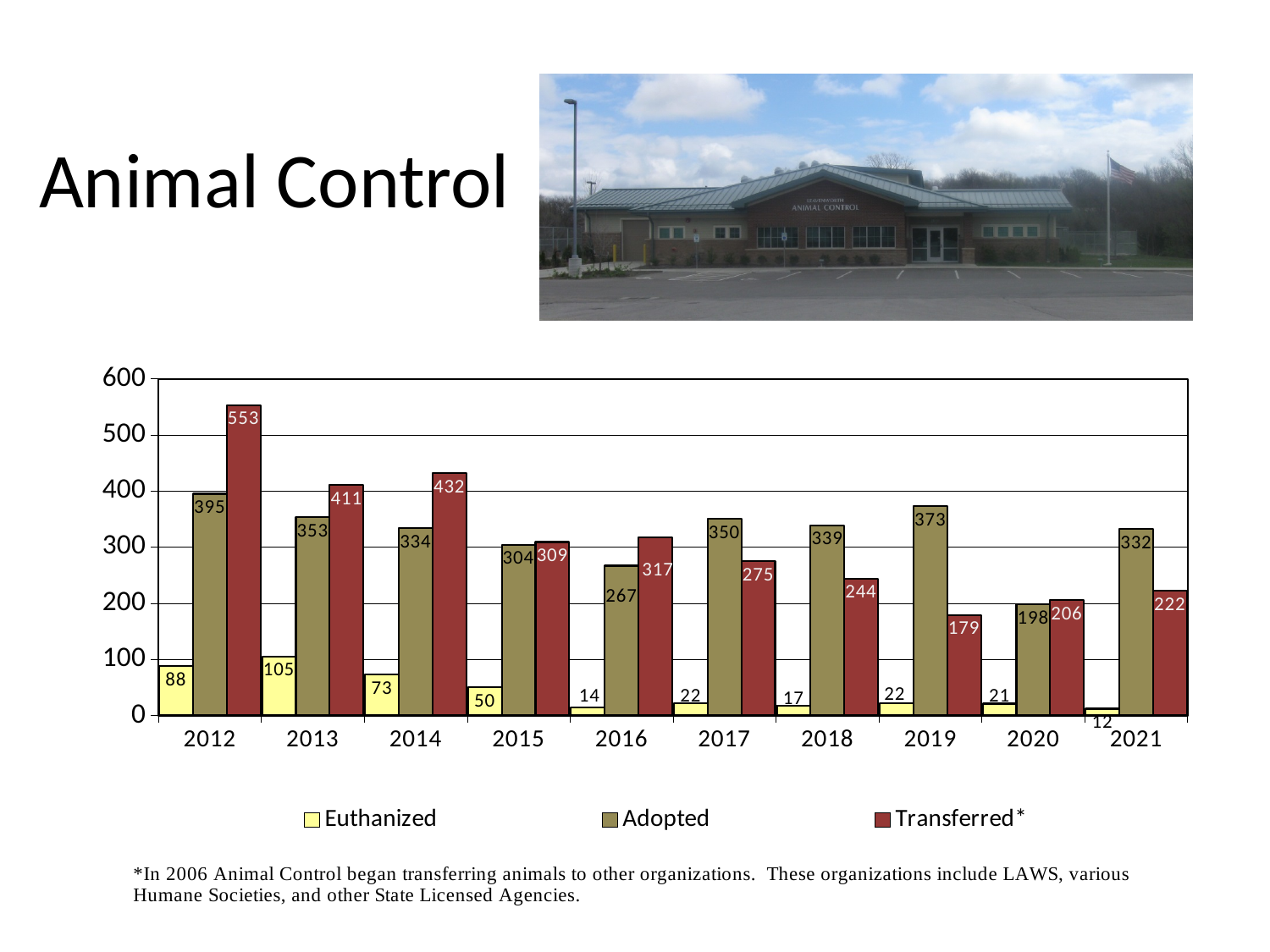
How many series does the legend list? 3 In 2017, which was larger, Adopted or Transferred*? Adopted What kind of chart is shown on the slide? bar chart In which year was the Adopted value lowest? 2020 What is the Transferred* value for 2012? 553 In which year was the Transferred* value highest? 2012 What is the difference between the Adopted and Transferred* values in 2014? 98 Which legend entry is marked with an asterisk? Transferred* How many animals were euthanized in 2021? 12 Is the Adopted value for 2016 greater or less than 300? less How many animals were adopted in 2019? 373 How many years are shown on the x axis? 10